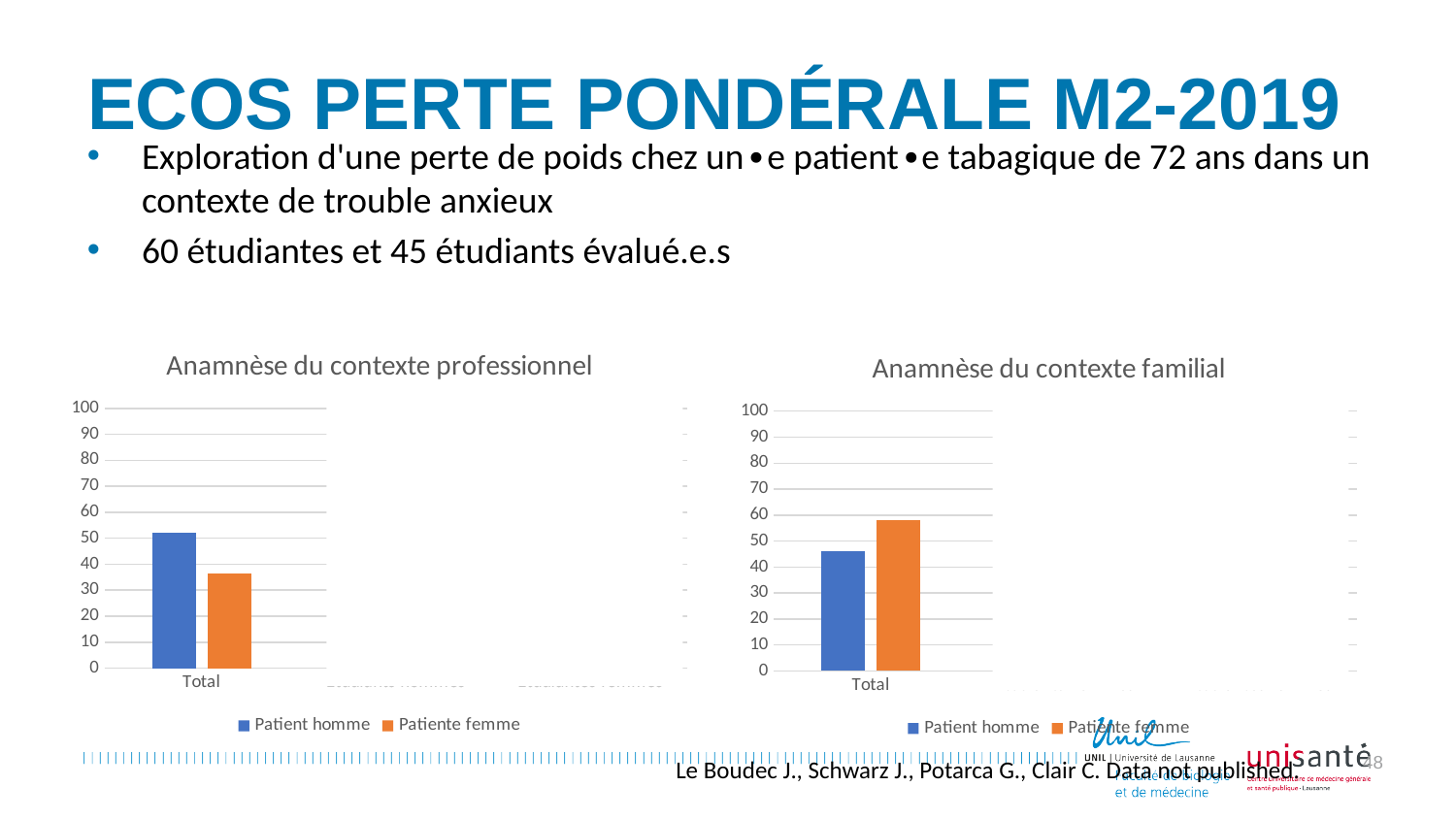
In 'Anamnèse du contexte professionnel', what colour represents the Patiente femme series? orange In 'Anamnèse du contexte familial', is the value for Patient homme (Total) greater or less than 40? greater What kind of chart is 'Anamnèse du contexte professionnel'? bar chart In 'Anamnèse du contexte familial', which series has the higher value for Total, Patient homme or Patiente femme? Patiente femme In 'Anamnèse du contexte professionnel', is the value for Patiente femme (Total) greater or less than 30? greater In 'Anamnèse du contexte professionnel', is the value for Patient homme (Total) greater or less than 40? greater In 'Anamnèse du contexte professionnel', which series has the higher value for Total, Patient homme or Patiente femme? Patient homme How many series does the legend of 'Anamnèse du contexte familial' list? 2 What is the title of the chart on the right side of the slide? Anamnèse du contexte familial